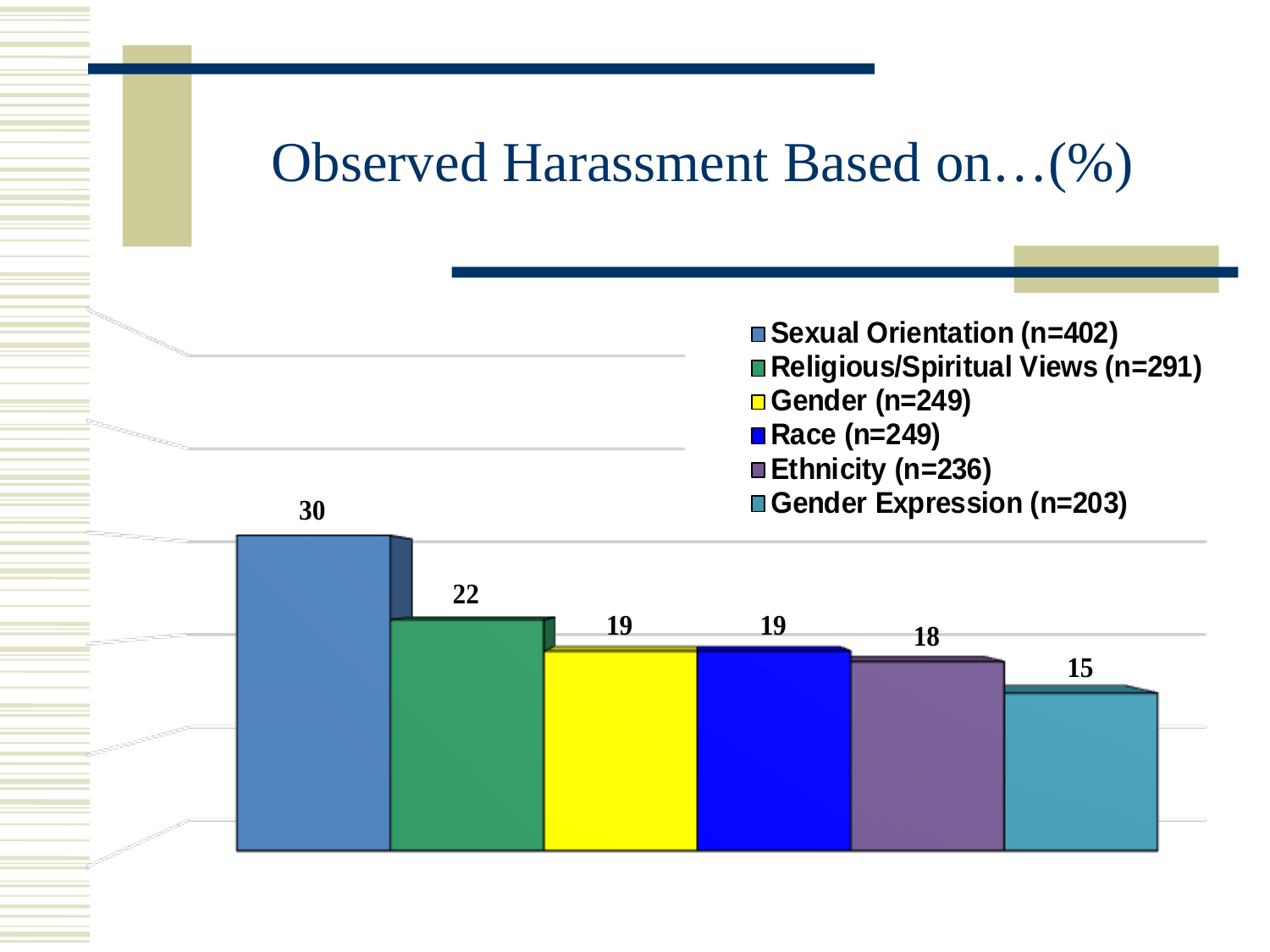
Which is larger, the value for Religious/Spiritual Views (n=291) or the value for Race (n=249)? Religious/Spiritual Views (n=291) What is the difference between the values for Religious/Spiritual Views (n=291) and Ethnicity (n=236)? 4 What is the value for Religious/Spiritual Views (n=291)? 22 What is the value for Sexual Orientation (n=402)? 30 How many series does the legend list? 6 What is the value for Ethnicity (n=236)? 18 What is the difference between the values for Sexual Orientation (n=402) and Gender Expression (n=203)? 15 Which category has the lowest value? Gender Expression (n=203) What kind of chart is shown on the slide? Bar chart What is the value for Gender Expression (n=203)? 15 Which category has the highest value? Sexual Orientation (n=402) What is the title of the chart? Observed Harassment Based on…(%)